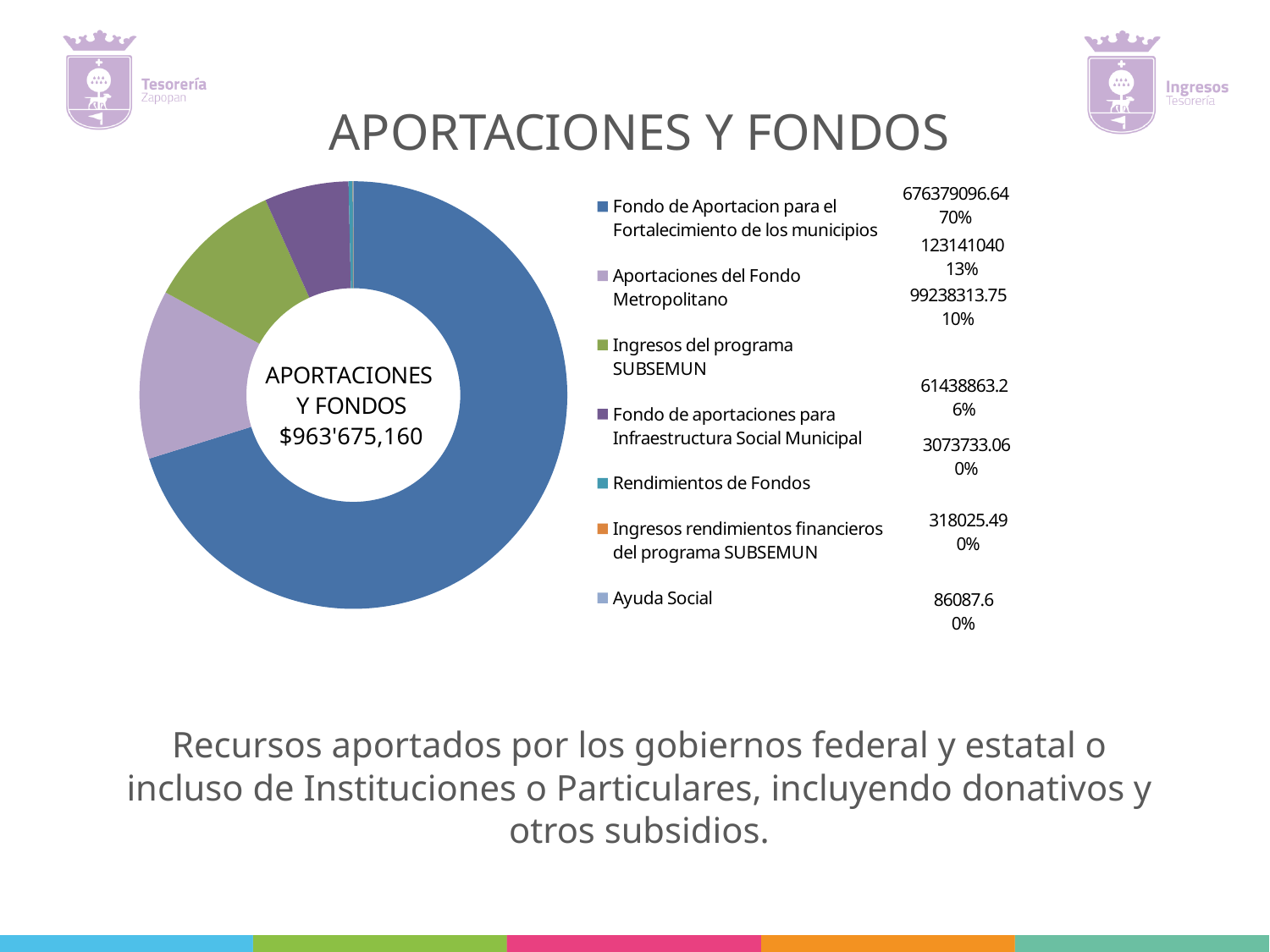
What kind of chart is shown on the slide? Pie chart (donut) What is the value shown for Rendimientos de Fondos? 3073733.06 What percentage share does Aportaciones del Fondo Metropolitano have? 13% How many categories does the legend of the chart list? 7 What total amount is printed in the centre of the donut chart? $963'675,160 Which category has the largest share of the chart? Fondo de Aportacion para el Fortalecimiento de los municipios What percentage share does Fondo de aportaciones para Infraestructura Social Municipal have? 6% What is the value shown for Ingresos del programa SUBSEMUN? 99238313.75 What is the value shown for Ayuda Social? 86087.6 What is the value shown for Fondo de Aportacion para el Fortalecimiento de los municipios? 676379096.64 Which is larger, Aportaciones del Fondo Metropolitano or Ingresos del programa SUBSEMUN? Aportaciones del Fondo Metropolitano Which category has the smallest value in the chart? Ayuda Social